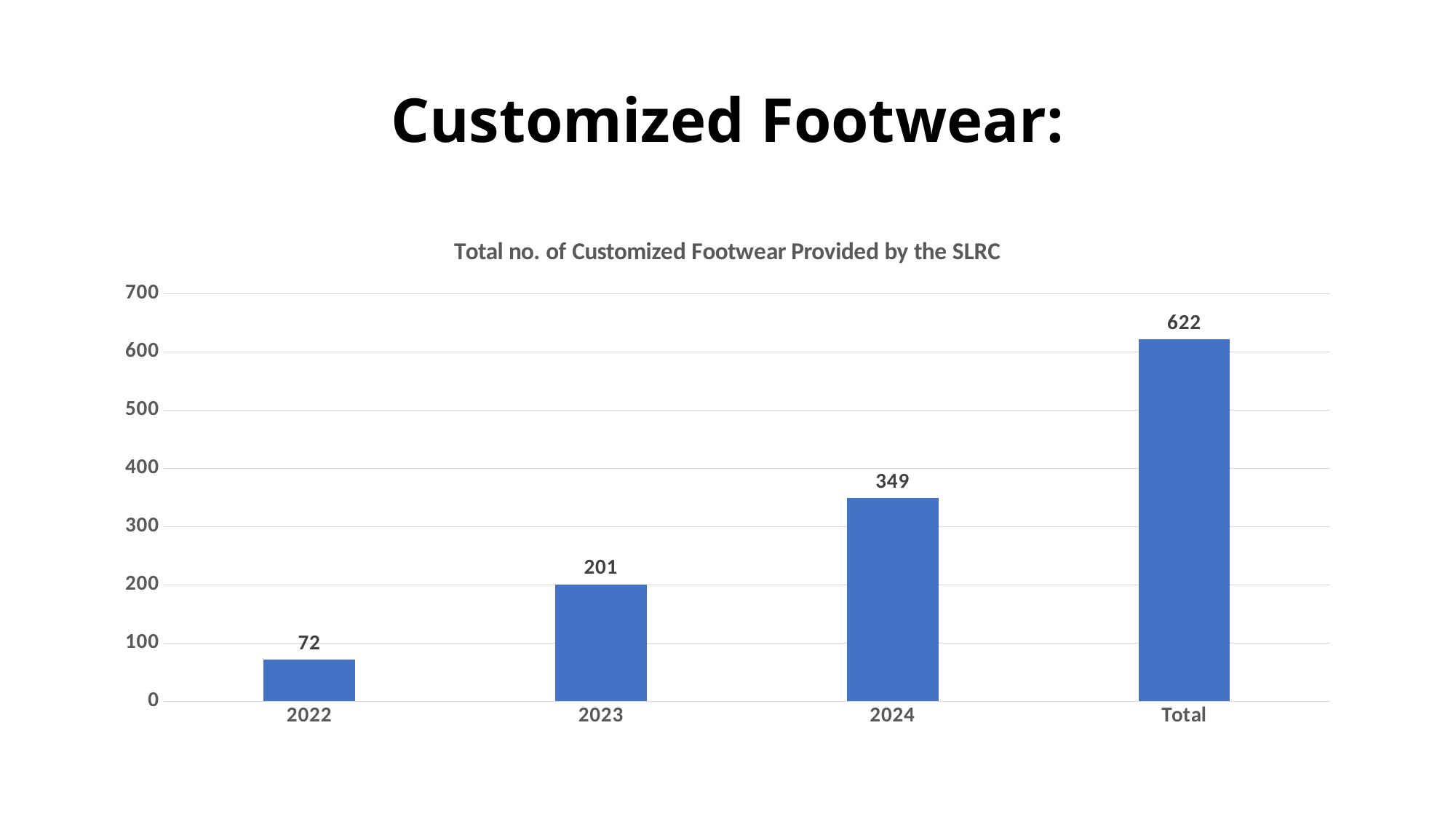
What kind of chart is shown? Bar chart What is the value for the Total bar? 622 Which is larger, the value for 2023 or the value for 2024? 2024 What is the value for 2024? 349 How many bars are shown in the chart? 4 What is the value for 2022? 72 What is the difference between the values for 2024 and 2023? 148 Which year (excluding Total) has the highest value? 2024 Which category has the lowest value? 2022 What is the value for 2023? 201 What is the title of the chart? Total no. of Customized Footwear Provided by the SLRC What is the difference between the values for 2023 and 2022? 129